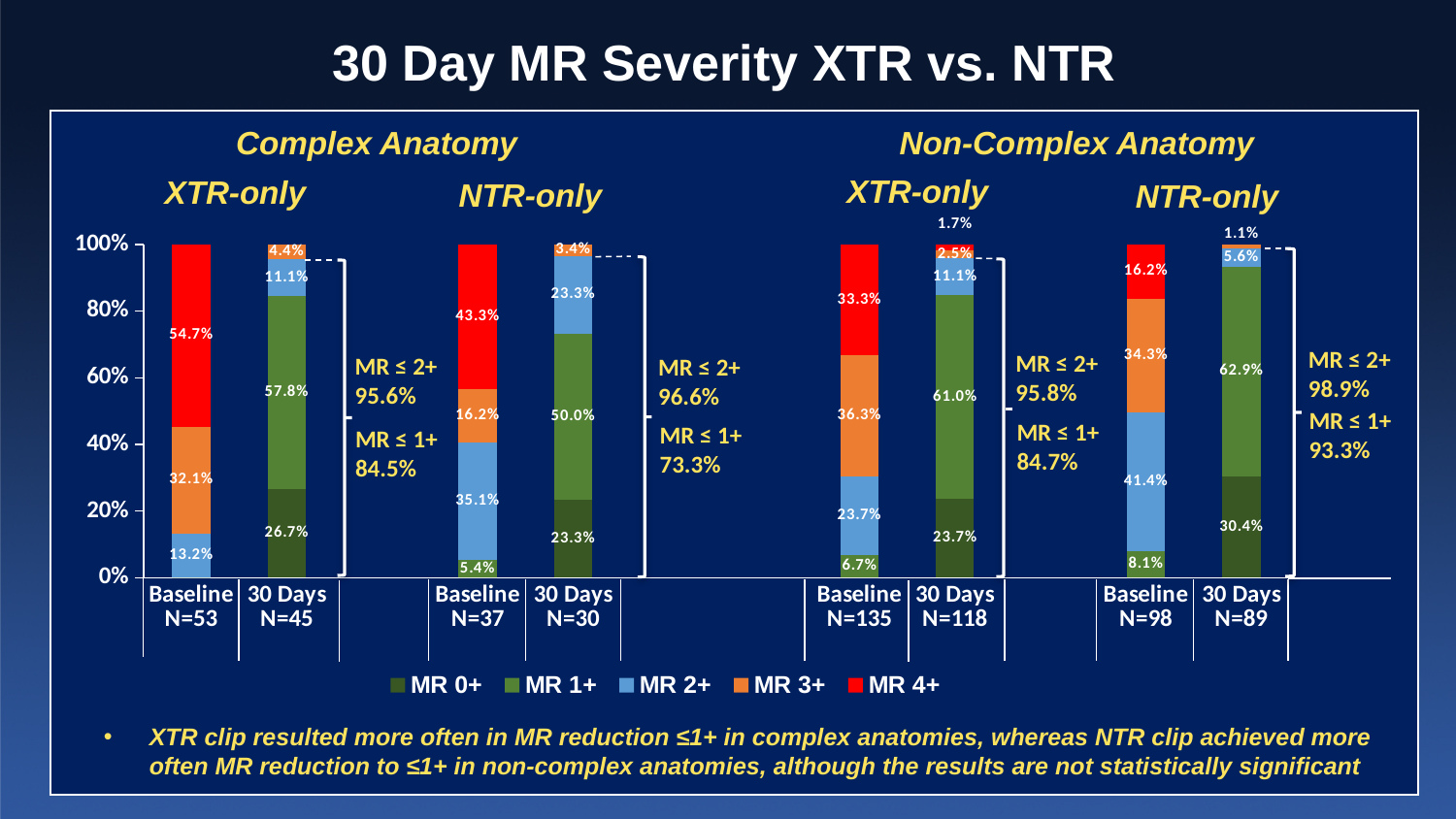
What kind of chart is shown on the slide? Stacked bar chart How many series does the legend list? 5 What is the MR 1+ share for the Non-Complex Anatomy NTR-only 30 Days bar? 62.9% What is the MR 4+ share for the Complex Anatomy XTR-only Baseline bar? 54.7% What MR ≤ 1+ percentage is annotated for the Complex Anatomy NTR-only group? 73.3% What is the sample size (N) for the Non-Complex Anatomy XTR-only 30 Days bar? N=118 What is the difference between the MR 1+ share at 30 Days for Complex Anatomy XTR-only and Complex Anatomy NTR-only? 7.8% Which is larger: the MR 4+ share in the Complex Anatomy XTR-only Baseline bar or in the Non-Complex Anatomy NTR-only Baseline bar? Complex Anatomy XTR-only Baseline What is the MR 0+ share for the Complex Anatomy NTR-only 30 Days bar? 23.3% Which segment is smallest in the Complex Anatomy NTR-only Baseline bar? MR 1+ What is the MR 2+ share for the Non-Complex Anatomy NTR-only Baseline bar? 41.4% Which segment is largest in the Non-Complex Anatomy XTR-only 30 Days bar? MR 1+